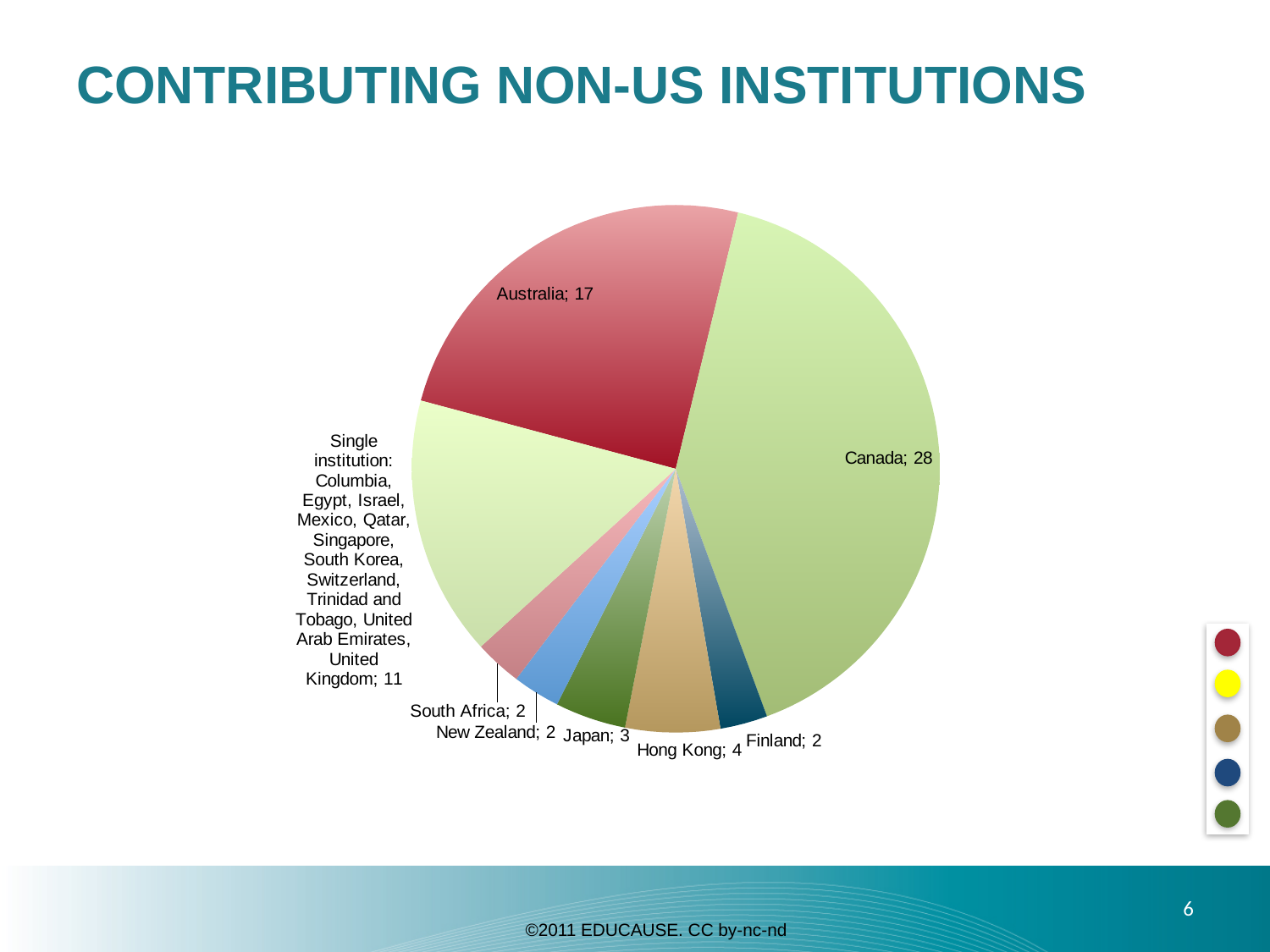
How many slices does the pie chart have? 8 Which has a larger value, Australia or the 'Single institution' group? Australia What is the title of the slide containing the chart? Contributing Non-US Institutions What is the difference between the values for Canada and Australia? 11 What value is shown for Australia in the pie chart? 17 What value is shown for Japan in the pie chart? 3 What is the difference between the values for Hong Kong and Finland? 2 What kind of chart is shown on the slide? Pie chart Which has a larger value, Japan or New Zealand? Japan What value is shown for Canada in the pie chart? 28 What value is shown for Hong Kong in the pie chart? 4 Which slice of the pie chart is the largest? Canada